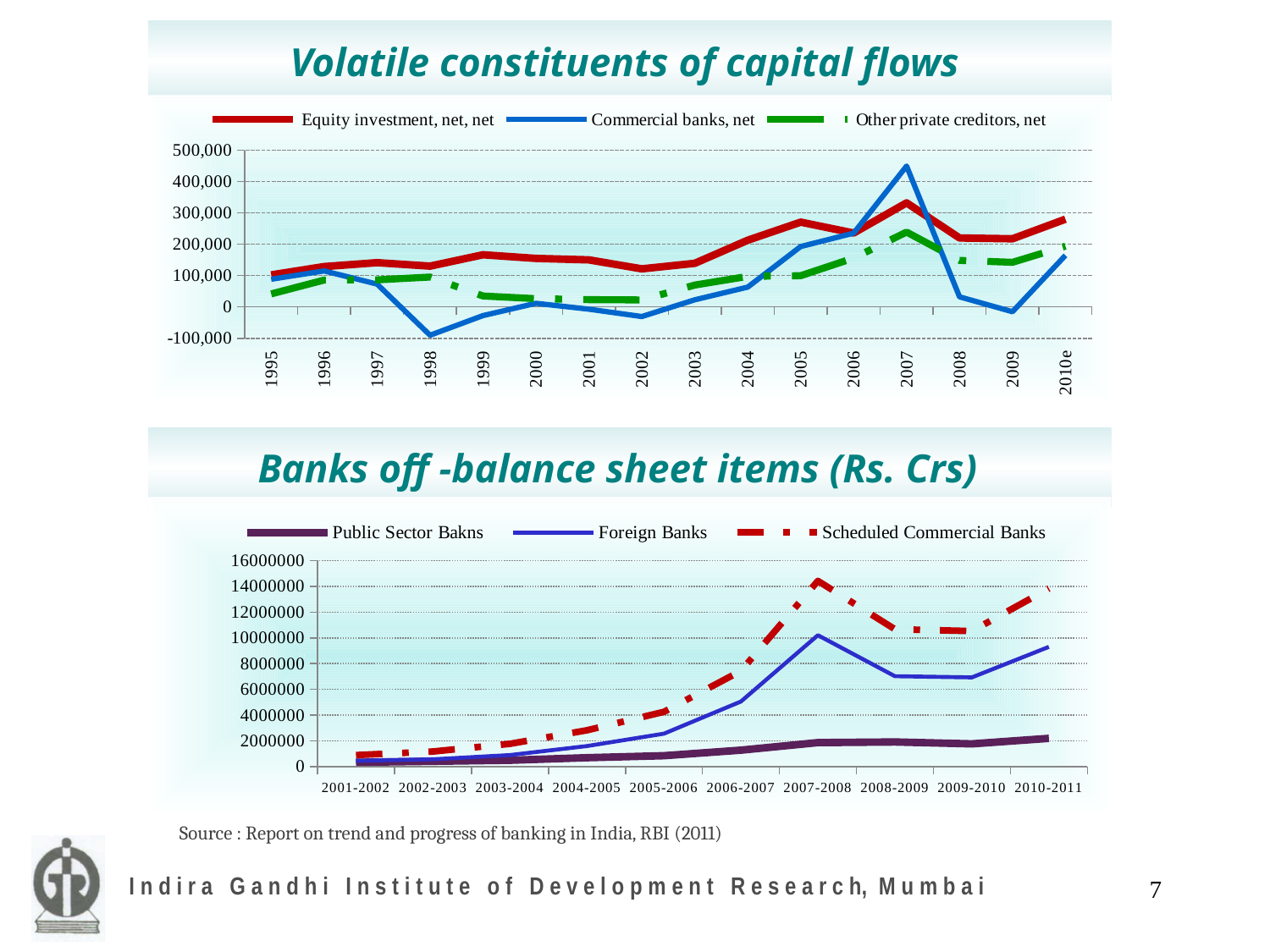
In the 'Volatile constituents of capital flows' chart, is the value for 'Equity investment, net, net' in 1995 greater or less than 200,000? less How many series does the legend of the 'Volatile constituents of capital flows' chart list? 3 In the 'Volatile constituents of capital flows' chart, in which year does the 'Commercial banks, net' series reach its highest value? 2007 In the 'Banks off -balance sheet items (Rs. Crs)' chart, is the value for Scheduled Commercial Banks in 2007-2008 greater or less than 12000000? greater In the 'Volatile constituents of capital flows' chart, is the value for 'Commercial banks, net' in 2007 greater or less than 400,000? greater How many years are shown on the x axis of the 'Volatile constituents of capital flows' chart? 16 What type of chart is the 'Volatile constituents of capital flows' chart? Line chart In the 'Banks off -balance sheet items (Rs. Crs)' chart, which series has the highest value in 2007-2008? Scheduled Commercial Banks What type of chart is the 'Banks off -balance sheet items (Rs. Crs)' chart? Line chart In the 'Volatile constituents of capital flows' chart, in which year does the 'Commercial banks, net' series reach its lowest value? 1998 How many periods are shown on the x axis of the 'Banks off -balance sheet items (Rs. Crs)' chart? 10 How many series does the legend of the 'Banks off -balance sheet items (Rs. Crs)' chart list? 3